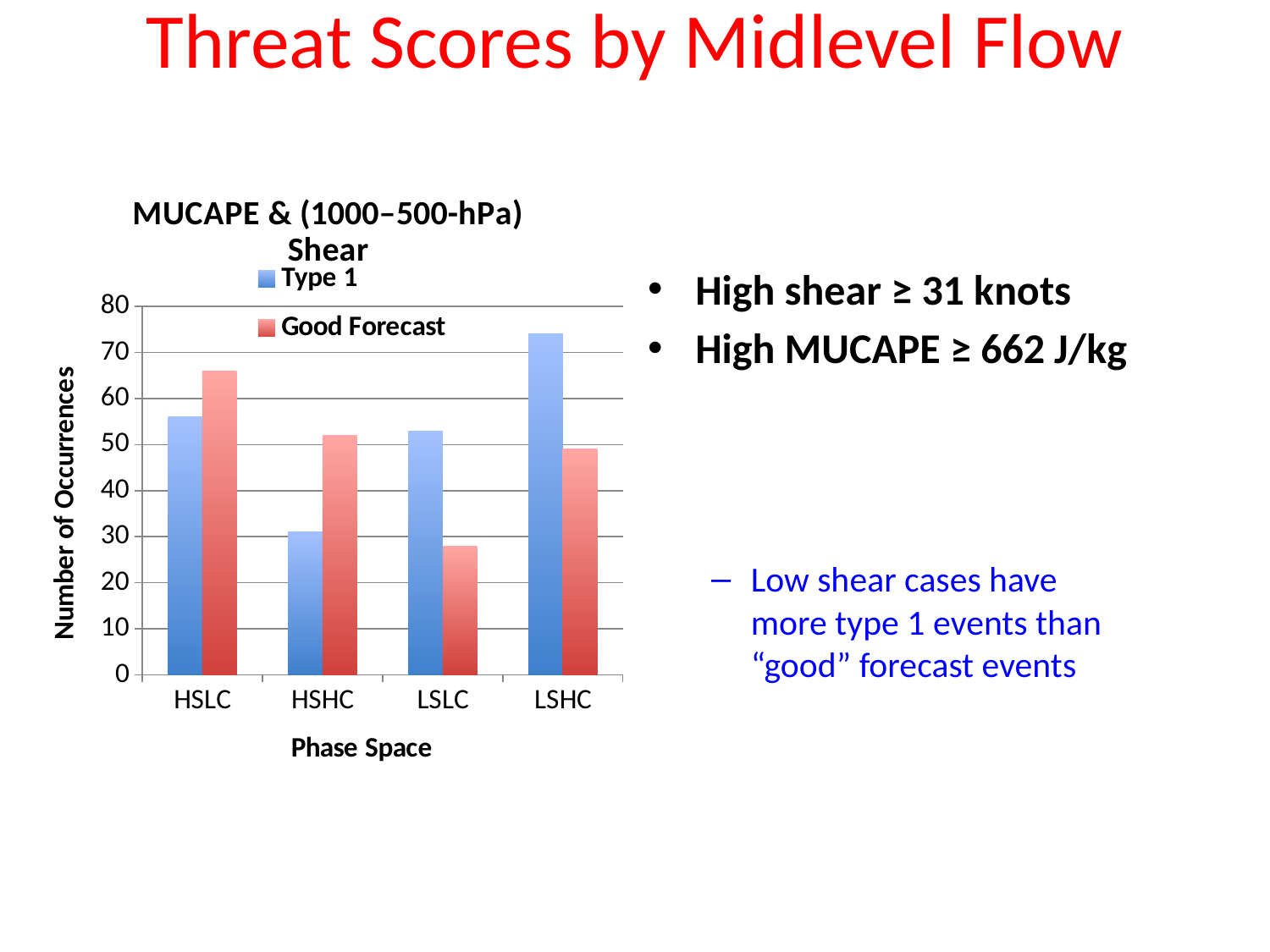
Which category has the highest Type 1 value? LSHC What kind of chart is shown on the slide? bar chart How many categories are shown on the x axis of the chart? 4 Which category has the lowest Type 1 value? HSHC For HSLC, which is larger: Type 1 or Good Forecast? Good Forecast How many series does the chart's legend list? 2 What is the title of the x axis of the chart? Phase Space For LSHC, which is larger: Type 1 or Good Forecast? Type 1 Is the Type 1 value for HSHC greater or less than 40? less Which category has the highest Good Forecast value? HSLC Is the Type 1 value for LSHC greater or less than 70? greater Which category has the lowest Good Forecast value? LSLC